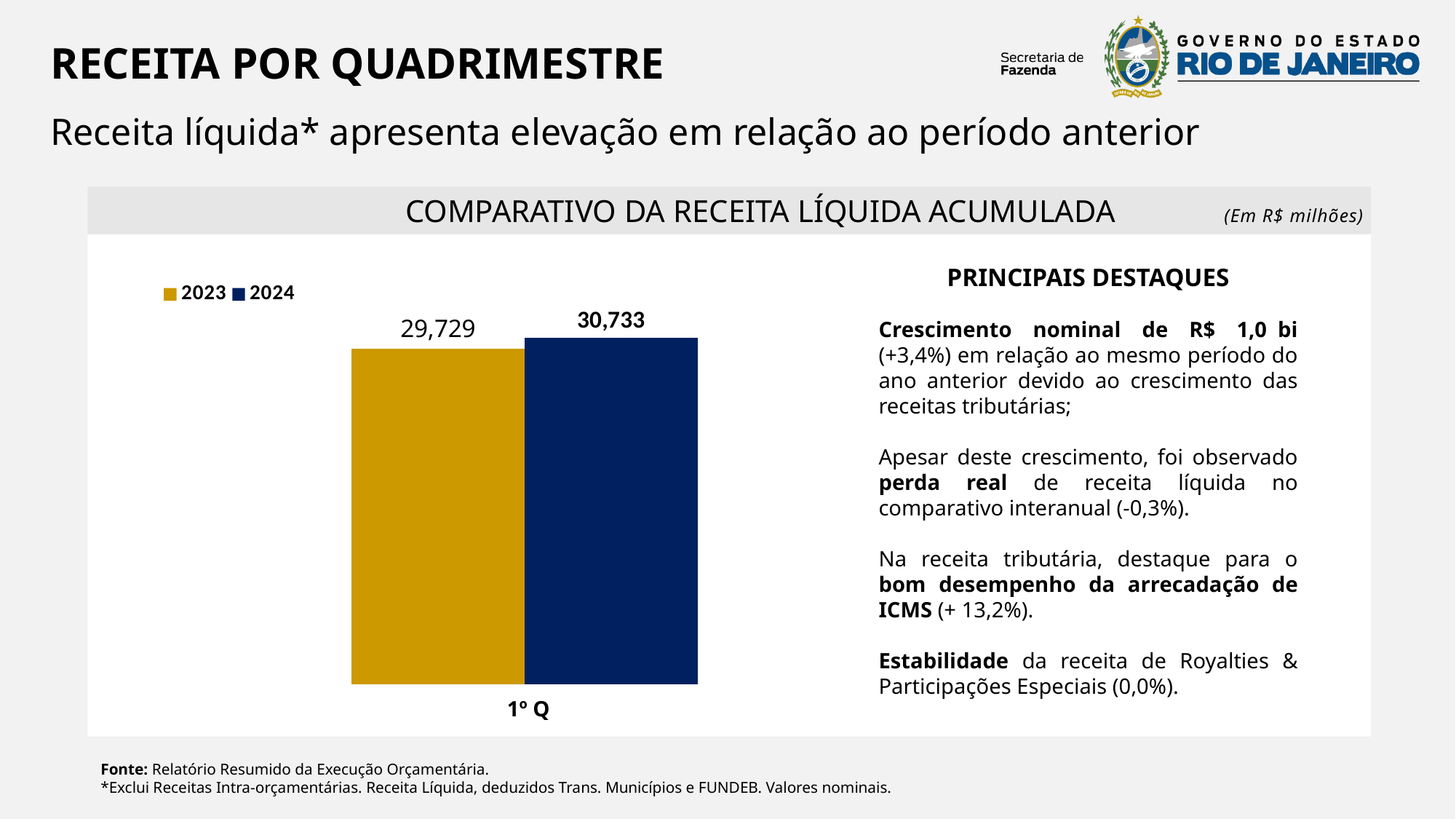
What is the label of the single category on the x axis? 1º Q How many series does the legend list? 2 Which series has the lowest value in the chart? 2023 What is the value for 2023 in the 1º Q category? 29,729 Which series has the highest value in the chart? 2024 Which series has the higher value for 1º Q, 2023 or 2024? 2024 What is the title of the chart? COMPARATIVO DA RECEITA LÍQUIDA ACUMULADA What is the difference between the 2024 and 2023 values for 1º Q? 1,004 What kind of chart is shown on the slide? Bar chart Which colour represents the 2024 series in the chart? Dark blue What is the value for 2024 in the 1º Q category? 30,733 How many categories are shown on the x axis? 1